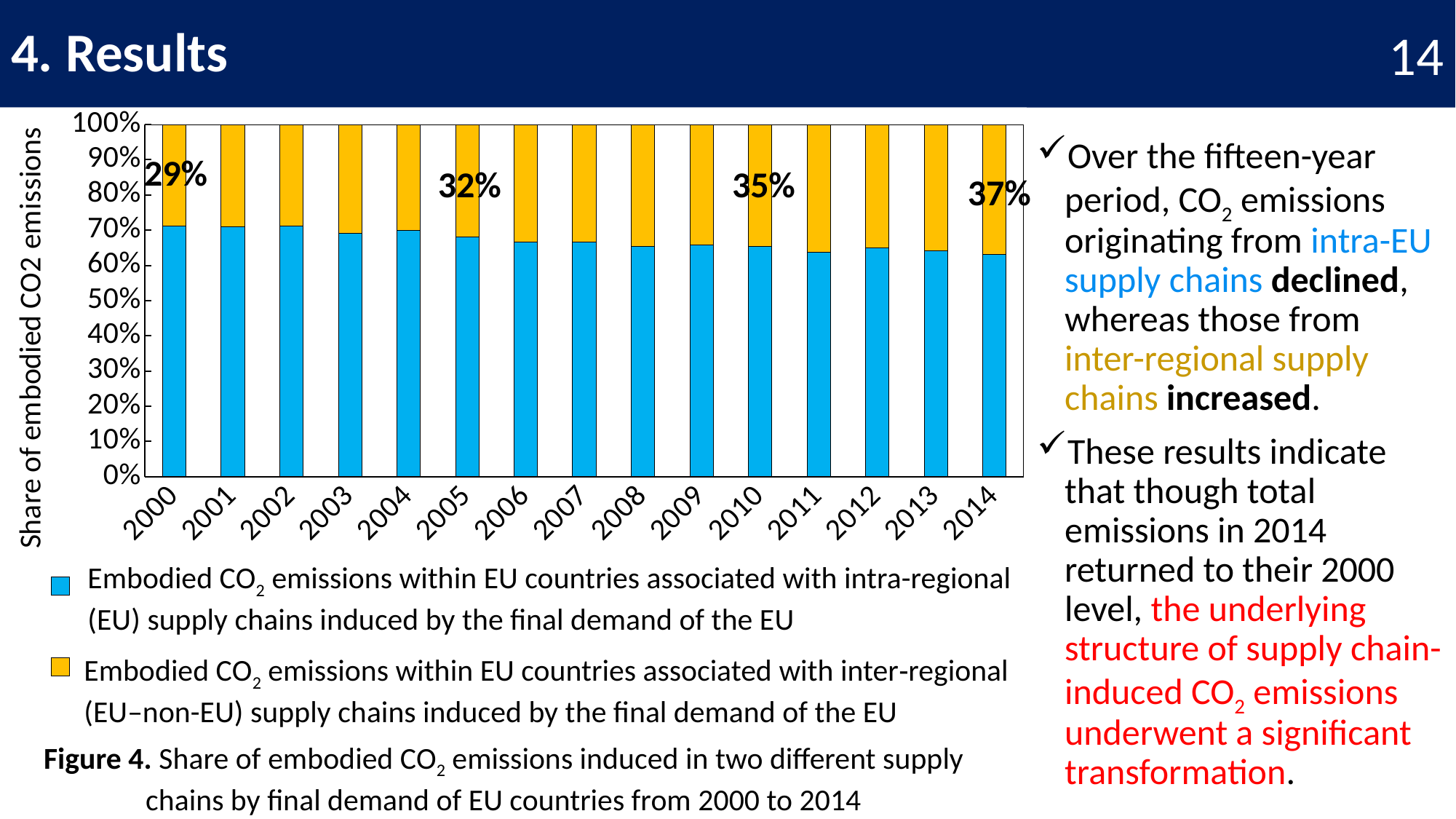
What kind of chart is shown on the slide? Stacked bar chart Is the share for intra-regional (EU) supply chains in 2000 greater or less than 60%? greater How many series does the chart's legend list? 2 What share of embodied CO2 emissions is labelled for the inter-regional (EU–non-EU) supply chains in 2014? 37% Is the share for intra-regional (EU) supply chains in 2014 greater or less than 70%? less How many years are shown along the x axis of the chart? 15 Which colour represents the intra-regional (EU) supply chain emissions in the chart? Blue By how many percentage points did the labelled inter-regional share increase from 2000 to 2014? 8 percentage points What share of embodied CO2 emissions is labelled for the inter-regional (EU–non-EU) supply chains in 2005? 32% Does the share of emissions from inter-regional (EU–non-EU) supply chains rise or fall from 2000 to 2014? Rise What share of embodied CO2 emissions is labelled for the inter-regional (EU–non-EU) supply chains in 2010? 35% What share of embodied CO2 emissions is labelled for the inter-regional (EU–non-EU) supply chains in 2000? 29%